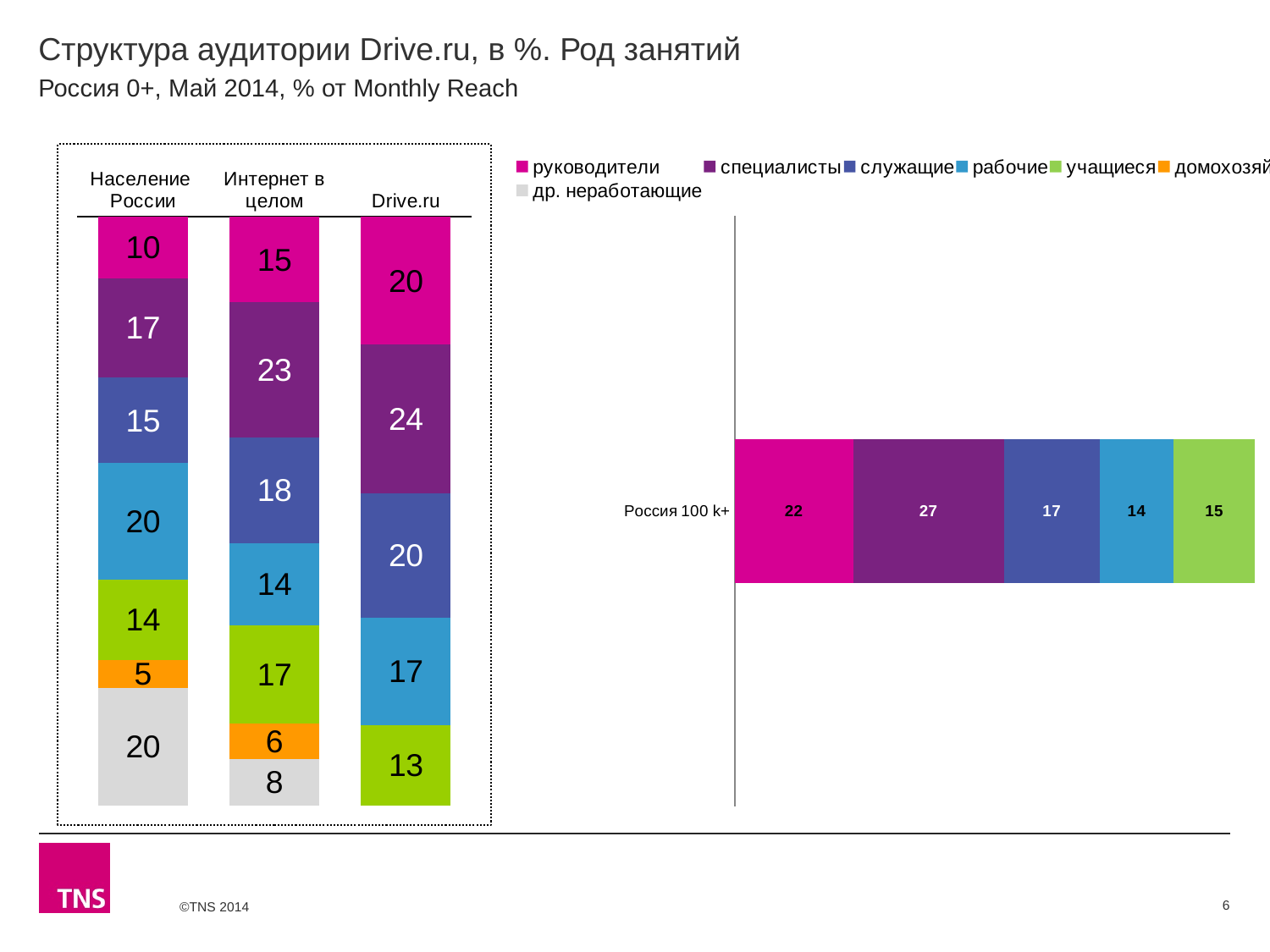
In the left chart, which is larger: the green (учащиеся) segment for Интернет в целом or for Drive.ru? Интернет в целом (17) What type of chart is the right chart (Россия 100 k+)? Stacked bar chart How many series does the legend list? 7 In the left chart, what is the total of the Drive.ru bar? 94 In the left chart, what is the difference between the purple (специалисты) segment for Drive.ru and for Население России? 7 In the left chart, what is the value of the pink (руководители) segment for Drive.ru? 20 In the right chart, what is the value of the purple (специалисты) segment for Россия 100 k+? 27 In the left chart, what is the value of the grey (др. неработающие) segment for Население России? 20 In the left chart, how many bars (audience groups) are shown? 3 In the left chart, what is the value of the purple (специалисты) segment for Интернет в целом? 23 In the right chart, which segment of the Россия 100 k+ bar has the lowest value? рабочие (14) In the right chart, which segment of the Россия 100 k+ bar has the highest value? специалисты (27)